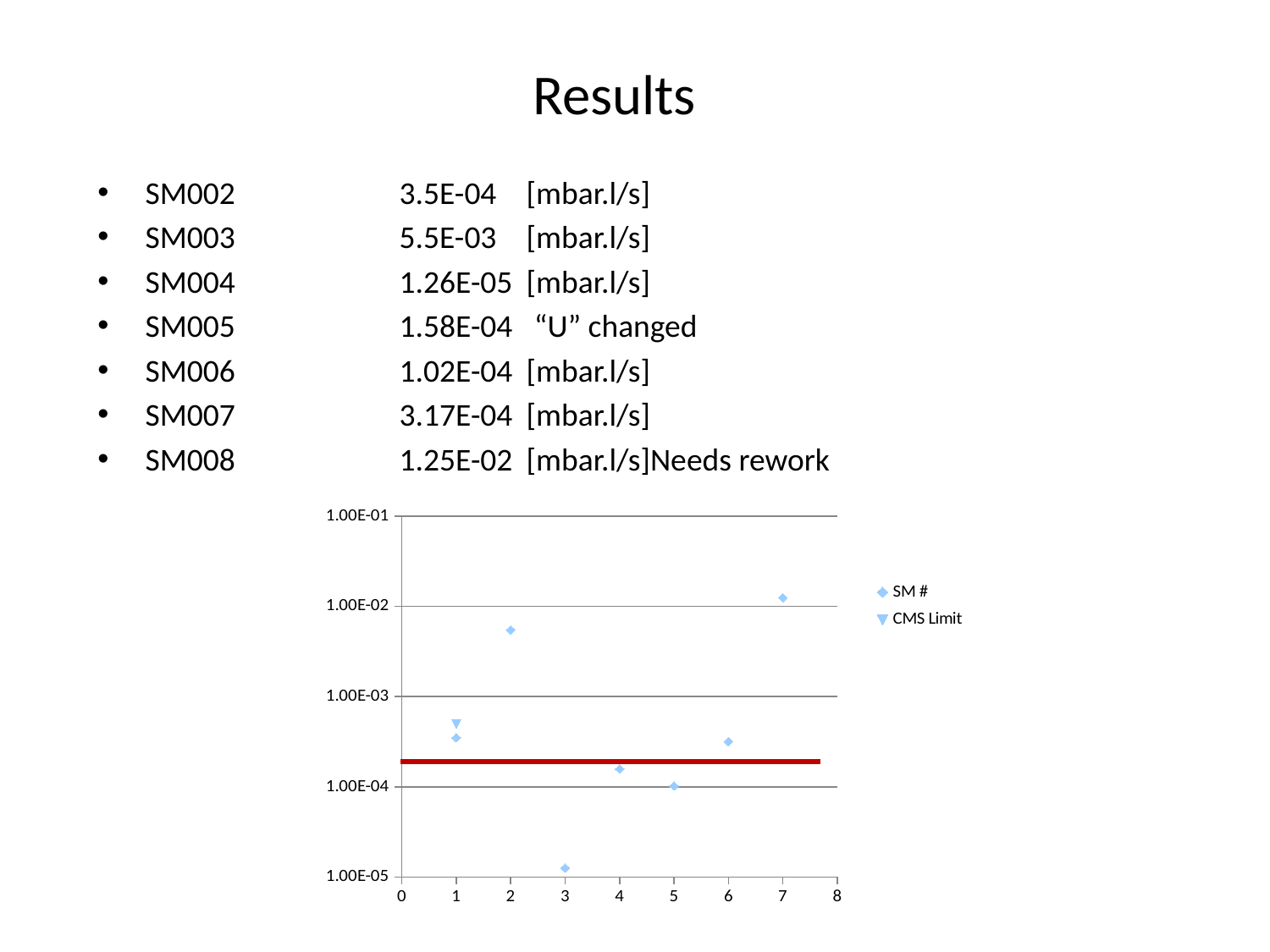
Is the SM # value at x = 3 greater or less than 1.00E-04? less How many series does the chart legend list? 2 Is the SM # value at x = 2 greater or less than 1.00E-03? greater What are the two series named in the chart legend? SM # and CMS Limit What kind of chart is shown on the slide? scatter chart How many diamond-marker data points are plotted for the SM # series? 7 At which x value does the SM # series reach its lowest point? 3 Which SM # point is higher, the one at x = 2 or the one at x = 7? x = 7 Is the SM # value at x = 1 greater or less than 1.00E-03? less What colour is the horizontal limit line drawn across the chart? red At which x value does the SM # series reach its highest point? 7